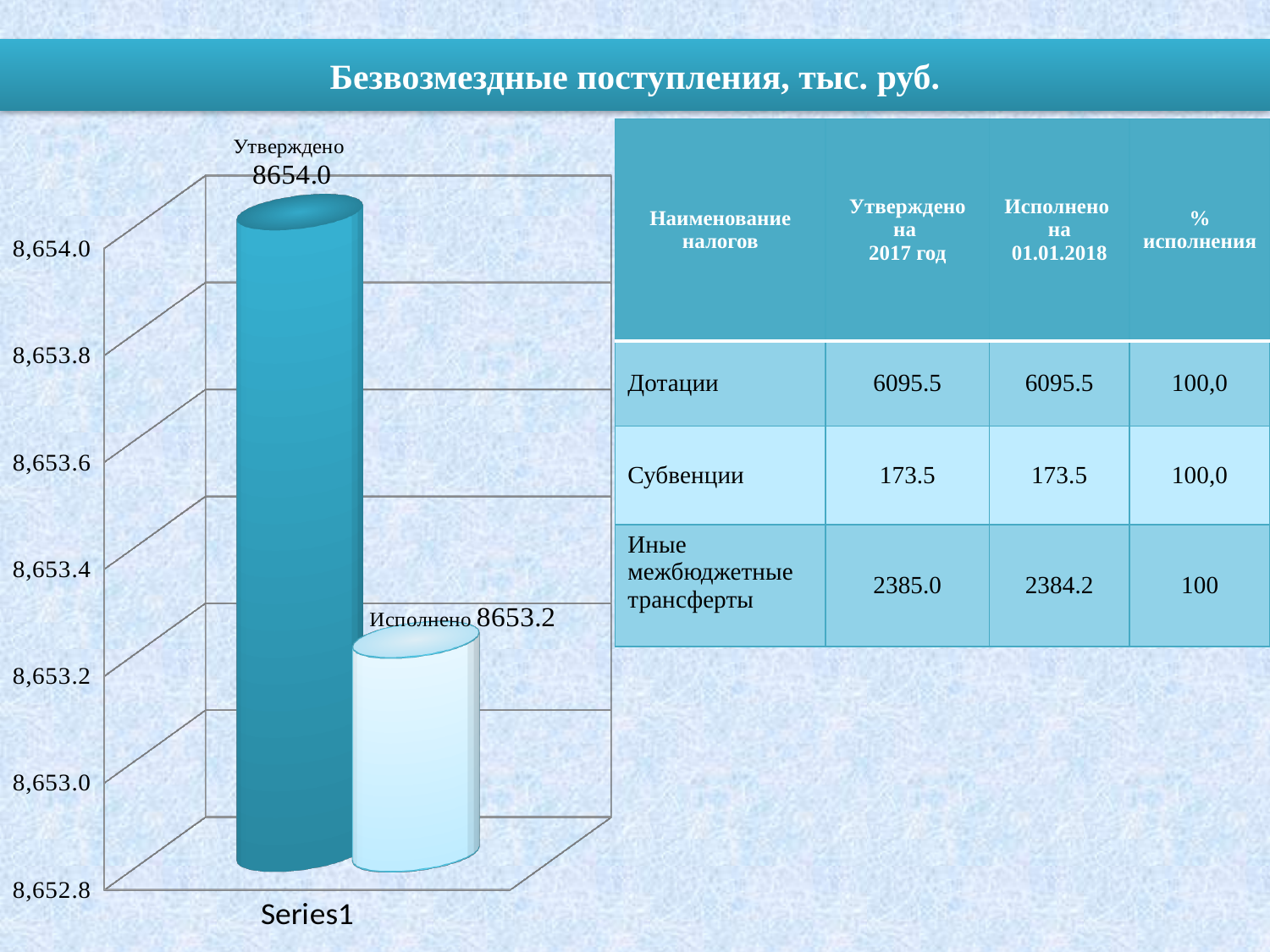
How many bars are plotted in the chart? 2 What kind of chart is shown on the slide? bar chart Which bar is taller, Утверждено or Исполнено? Утверждено What value is shown for the bar labelled Исполнено? 8653.2 Is the value for Исполнено greater or less than 8,653.4? less Which bar has the highest value? Утверждено Is the value for Утверждено greater or less than 8,653.8? greater What is the lowest value shown on the vertical axis of the chart? 8,652.8 What is the difference between the Утверждено value and the Исполнено value? 0.8 Which bar has the lowest value? Исполнено What value is shown for the bar labelled Утверждено? 8654.0 What label appears on the horizontal axis of the chart? Series1